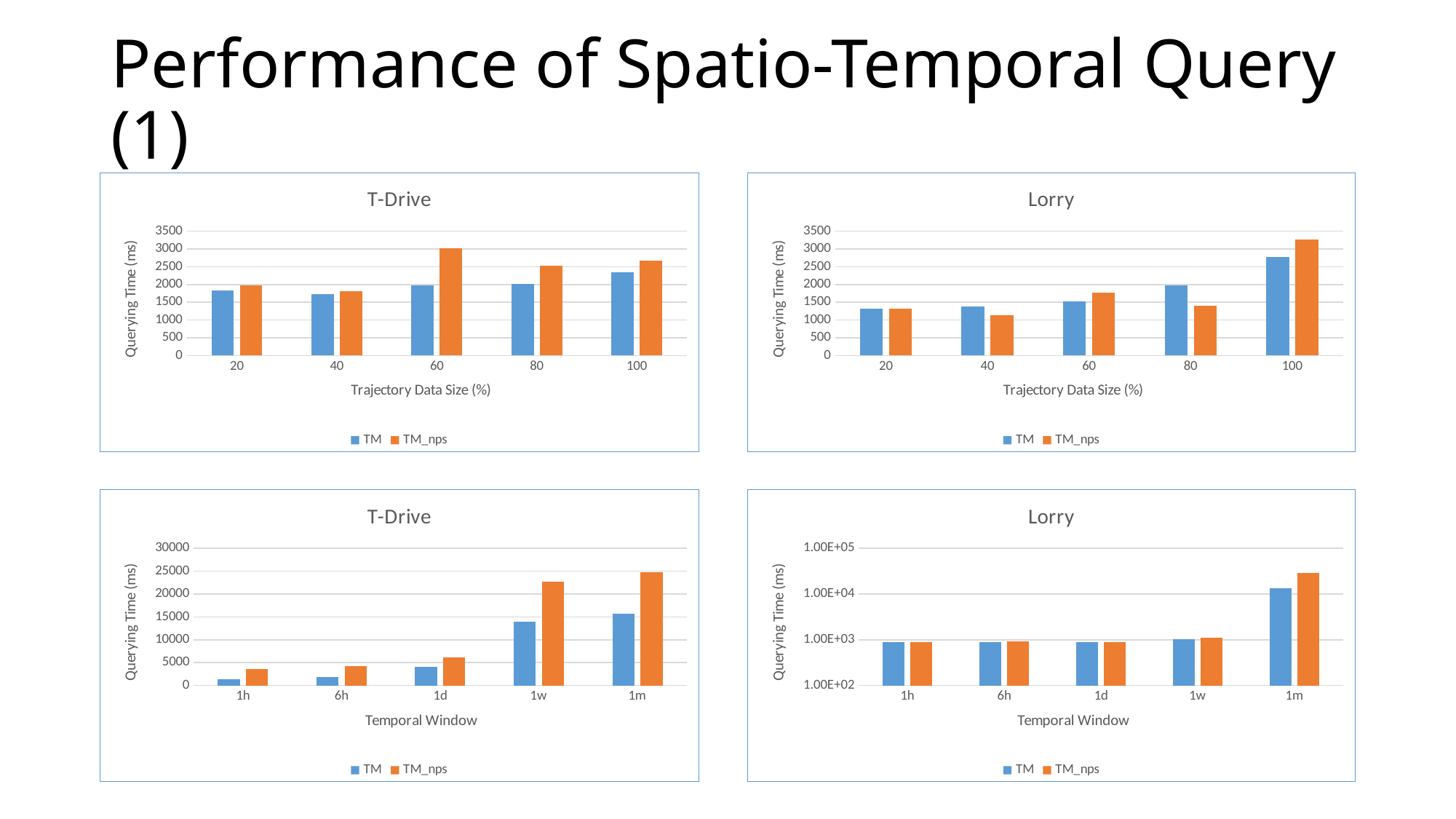
In the bottom-left T-Drive chart, is the TM value for the 1w temporal window greater or less than 15000? less In the top-right Lorry chart, is the TM_nps value at 100% trajectory data size greater or less than 3000? greater In the top-right Lorry chart, which series has the larger value at 40% trajectory data size, TM or TM_nps? TM In the top-left T-Drive chart, at which trajectory data size is the TM_nps querying time highest? 60 In the bottom-left T-Drive chart, do the TM_nps values rise or fall as the temporal window increases from 1h to 1m? rise In the top-left T-Drive chart, how many series does the legend list? 2 In the top-left T-Drive chart, is the TM value at 100% trajectory data size greater or less than 2000? greater In the top-left T-Drive chart, what kind of chart is shown? bar chart In the bottom-right Lorry chart, which series has the larger value for the 1m temporal window, TM or TM_nps? TM_nps In the top-left T-Drive chart, how many trajectory data size categories are shown on the x axis? 5 In the bottom-right Lorry chart, what is the label of the x axis? Temporal Window In the top-right Lorry chart, at which trajectory data size is the TM querying time highest? 100